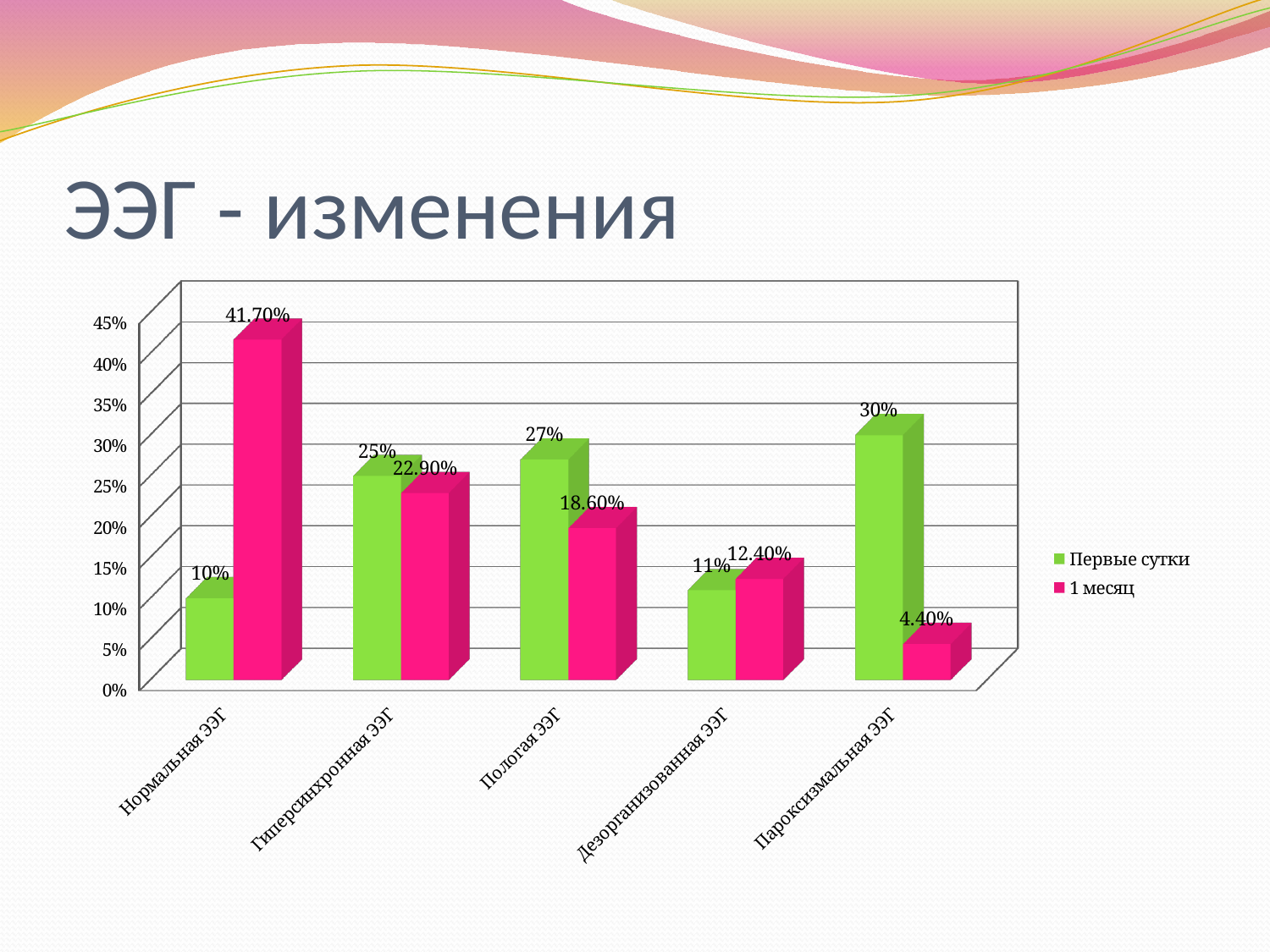
How many series does the legend list? 2 What kind of chart is shown on the slide? Bar chart Which is larger for Гиперсинхронная ЭЭГ: the Первые сутки value or the 1 месяц value? Первые сутки What is the difference between the 1 месяц and Первые сутки values for Нормальная ЭЭГ? 31.70% What is the title of the slide? ЭЭГ - изменения What is the difference between the Первые сутки and 1 месяц values for Пароксизмальная ЭЭГ? 25.60% What is the value for Пологая ЭЭГ in the 1 месяц series? 18.60% How many categories are shown on the x axis? 5 Which category has the highest value in the 1 месяц series? Нормальная ЭЭГ What is the value for Пароксизмальная ЭЭГ in the Первые сутки series? 30% Which category has the lowest value in the Первые сутки series? Нормальная ЭЭГ What is the value for Нормальная ЭЭГ in the 1 месяц series? 41.70%